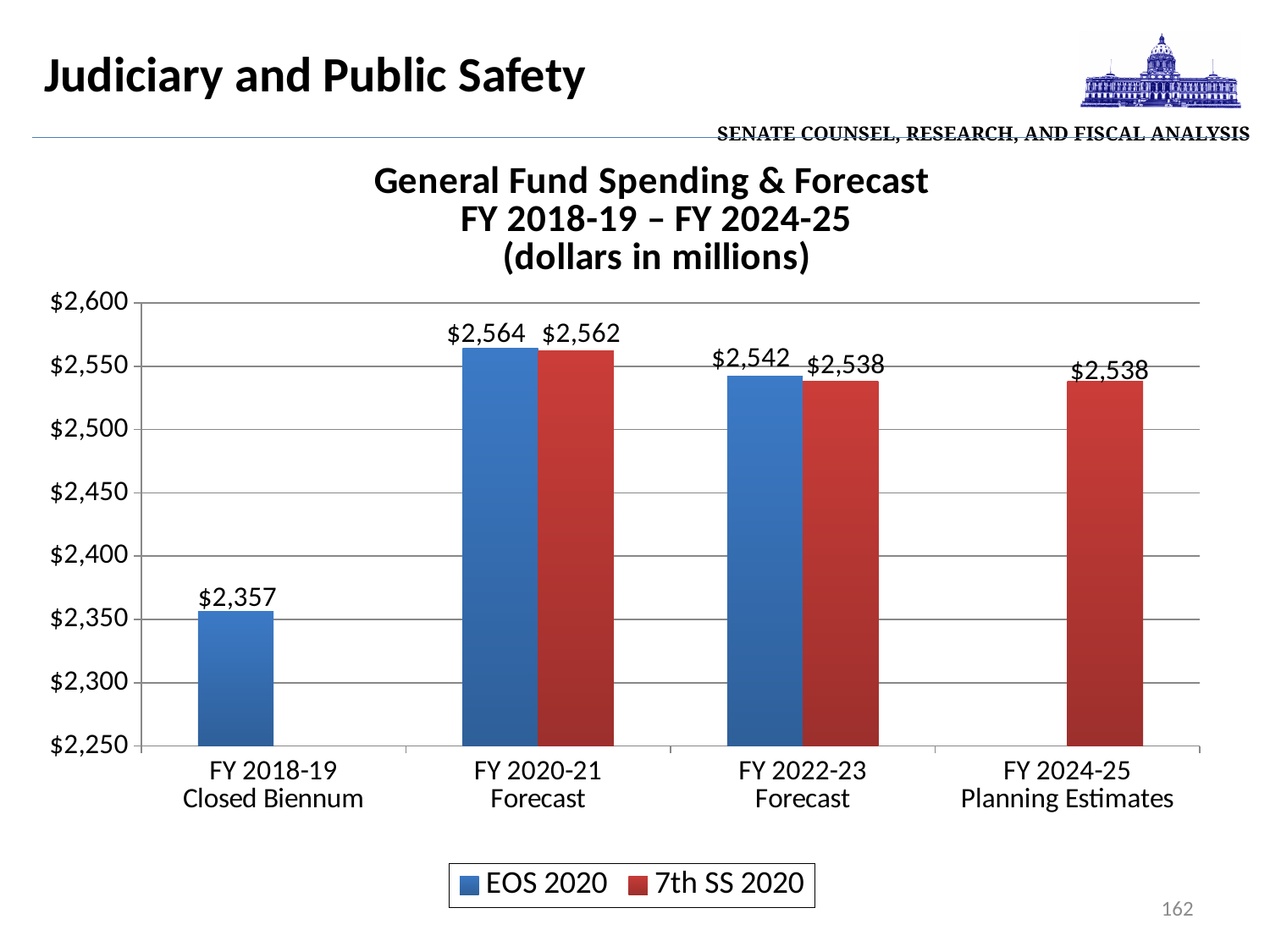
What is the 7th SS 2020 value for FY 2024-25 Planning Estimates? $2,538 What kind of chart is shown on the slide? Bar chart How many series does the legend list? 2 What is the difference between the EOS 2020 and 7th SS 2020 values for FY 2022-23 Forecast? $4 What is the EOS 2020 value for FY 2022-23 Forecast? $2,542 What is the EOS 2020 value for FY 2018-19 Closed Biennum? $2,357 How many categories are shown on the x axis? 4 What is the 7th SS 2020 value for FY 2020-21 Forecast? $2,562 Which is larger: the EOS 2020 value for FY 2020-21 Forecast or the EOS 2020 value for FY 2022-23 Forecast? FY 2020-21 Forecast Which category has the lowest EOS 2020 value? FY 2018-19 Closed Biennum What is the difference between the EOS 2020 values for FY 2020-21 Forecast and FY 2018-19 Closed Biennum? $207 Which category has the highest EOS 2020 value? FY 2020-21 Forecast